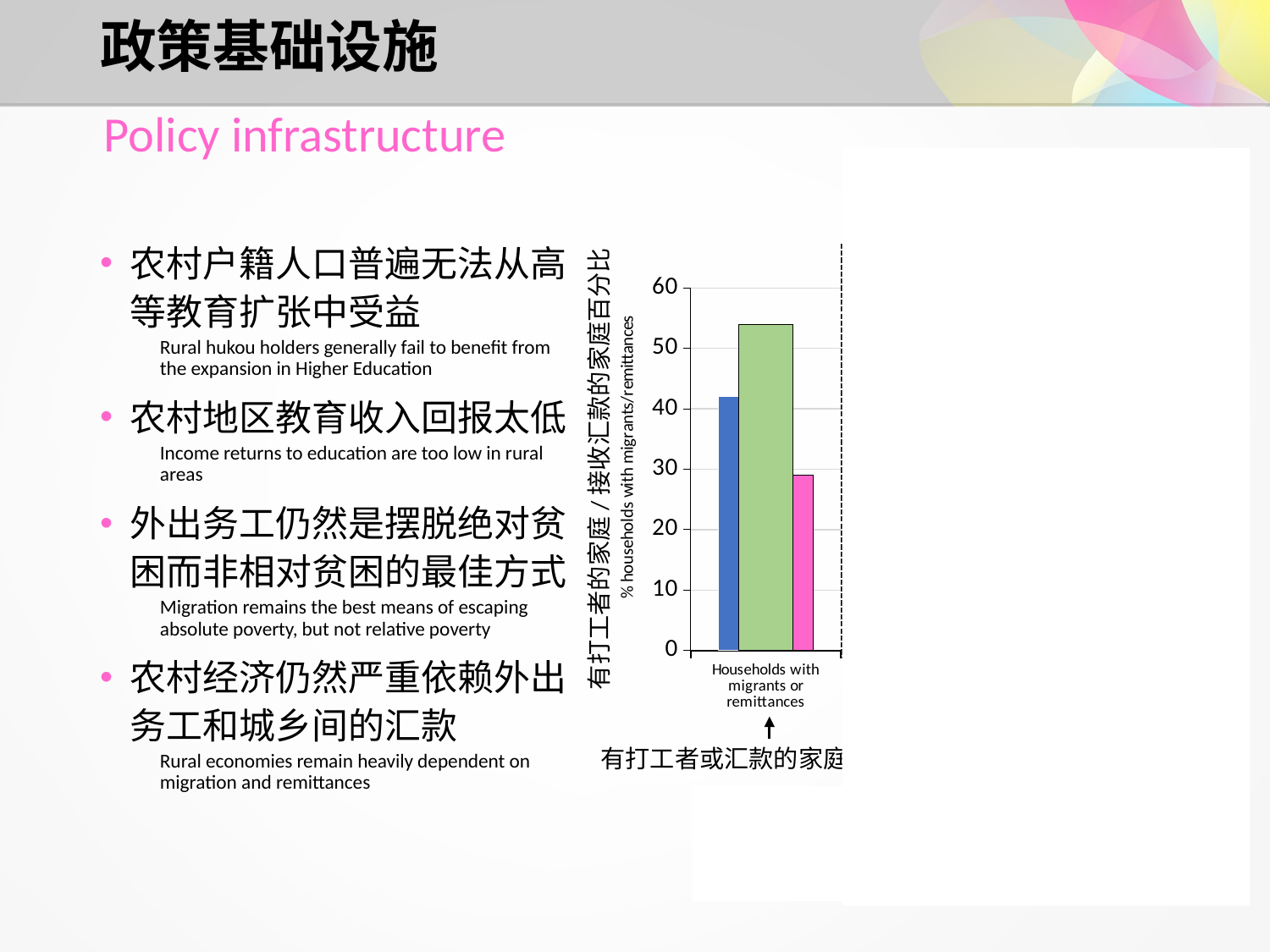
Which bar is the tallest in the chart: the blue, green or pink bar? green How many categories are shown on the x axis of the chart? 1 Is the value of the green bar greater or less than 50? greater What is the category label shown on the x axis of the chart? Households with migrants or remittances What kind of chart is shown on the slide? bar chart What is the highest value shown on the y axis of the chart? 60 Is the value of the blue bar greater or less than 40? greater How many bars are plotted in the chart? 3 Which bar is the shortest in the chart: the blue, green or pink bar? pink Is the value of the pink bar greater or less than 30? less Which is larger, the blue bar or the pink bar? blue bar